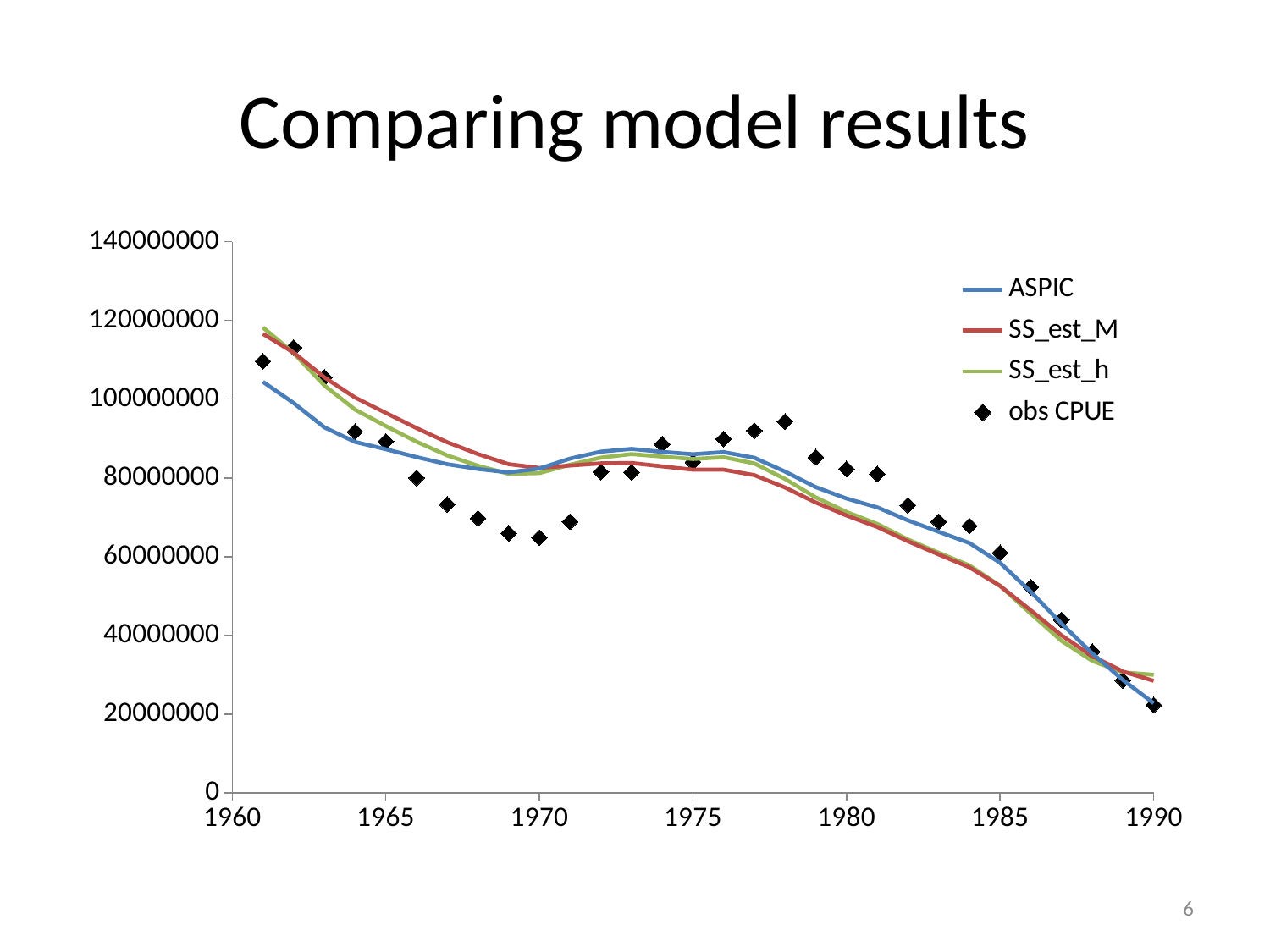
At 1970, which is higher, the ASPIC line or the obs CPUE point? ASPIC What is the title of the chart? Comparing model results How many series does the legend list? 4 What kind of chart is shown on the slide? line chart Is the obs CPUE value for 1970 greater or less than 80000000? less At 1961, which is higher, the ASPIC line or the SS_est_h line? SS_est_h At 1978, which is higher, the obs CPUE point or the ASPIC line? obs CPUE Is the obs CPUE value for 1990 greater or less than 40000000? less Is the obs CPUE value for 1978 greater or less than 80000000? greater Overall, do the values rise or fall from 1960 to 1990? fall Which series is plotted with black diamond markers rather than a line? obs CPUE